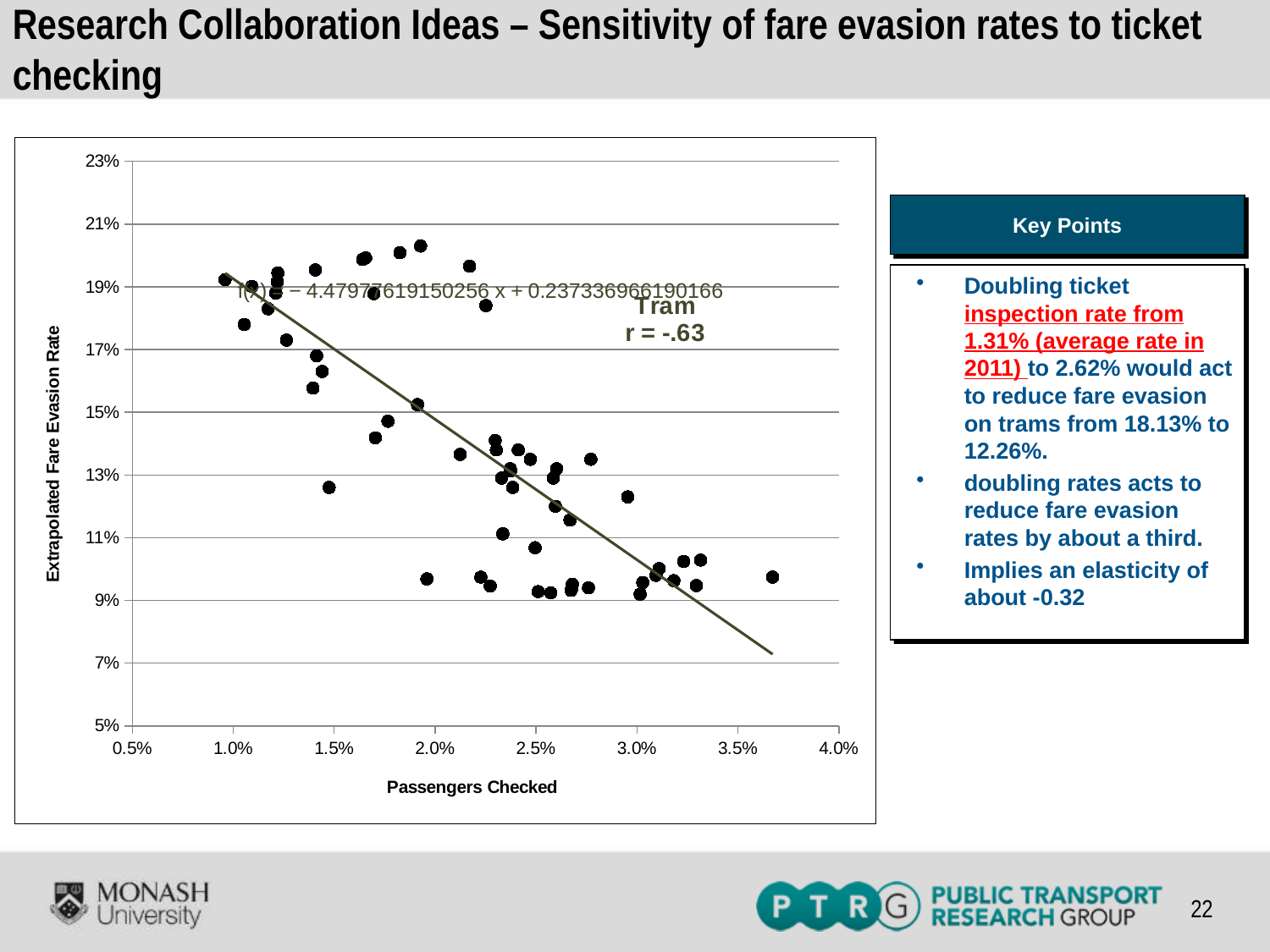
Is the fare evasion rate of the rightmost plotted point (at about 3.7% passengers checked) greater or less than 11%? less What correlation coefficient (r) is printed on the chart? r = -.63 What kind of chart is shown on the slide? Scatter chart Is the fare evasion rate of the leftmost plotted point (at about 1.0% passengers checked) greater or less than 17%? greater Is the lowest plotted fare evasion rate greater or less than 11%? less What is the title printed inside the chart? Tram Does the fitted trend line slope upward or downward from left to right? Downward As Passengers Checked increases along the x axis, does the Extrapolated Fare Evasion Rate generally rise or fall? Fall